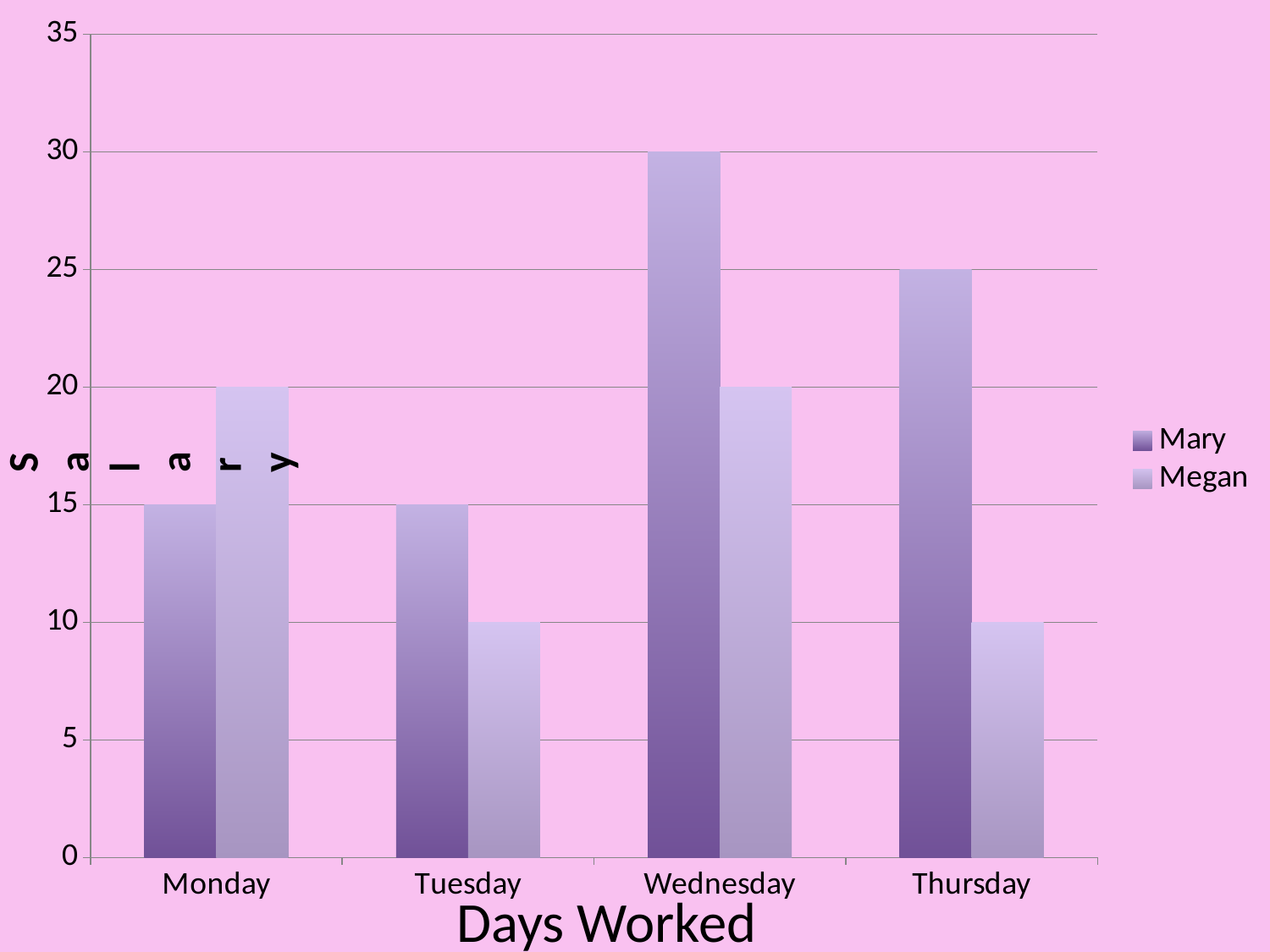
What is Megan's salary on Monday? 20 What is Megan's salary on Thursday? 10 What is Mary's salary on Wednesday? 30 What is the difference between Mary's and Megan's salary on Thursday? 15 How many days are shown on the x axis? 4 On which day is Mary's salary highest? Wednesday What is the label of the x axis? Days Worked On which day is Megan's salary highest? Monday and Wednesday How many series does the legend list? 2 Who has the larger salary on Monday, Mary or Megan? Megan What kind of chart is shown on the slide? bar chart What is the label of the y axis? Salary